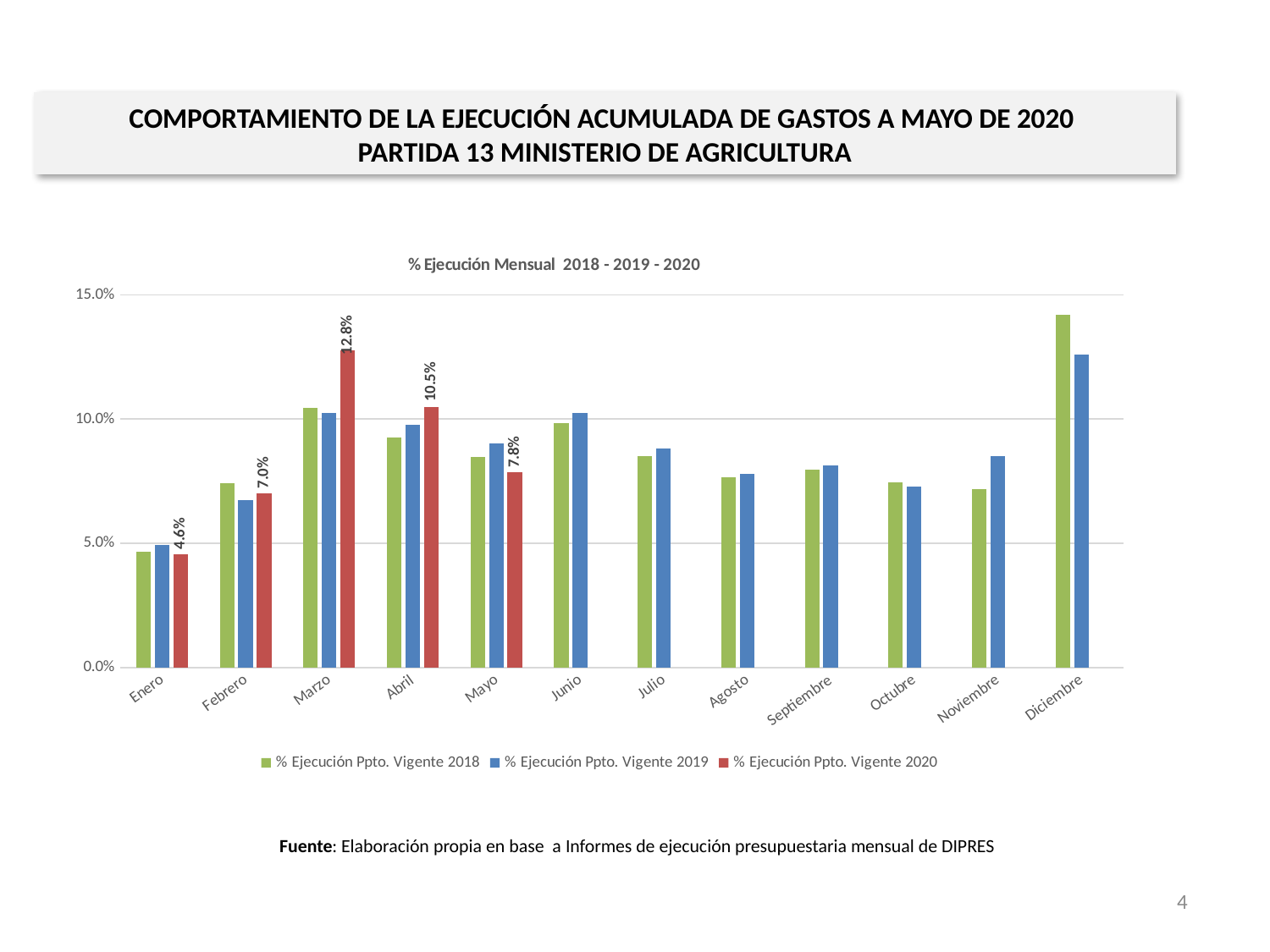
Is the value for Enero in the % Ejecución Ppto. Vigente 2018 series greater or less than 5.0%? less What is the value for Enero in the % Ejecución Ppto. Vigente 2020 series? 4.6% What is the difference between the Marzo and Abril values in the % Ejecución Ppto. Vigente 2020 series? 2.3% Is the value for Diciembre in the % Ejecución Ppto. Vigente 2018 series greater or less than 10.0%? greater How many series does the legend list? 3 Which month has the lowest value in the % Ejecución Ppto. Vigente 2020 series? Enero What is the value for Marzo in the % Ejecución Ppto. Vigente 2020 series? 12.8% In the % Ejecución Ppto. Vigente 2020 series, which is larger: Febrero or Mayo? Mayo What kind of chart is shown on the slide? bar chart Do the values in the % Ejecución Ppto. Vigente 2020 series rise or fall from Marzo to Mayo? fall How many months are shown on the x axis of the chart? 12 Which month has the highest value in the % Ejecución Ppto. Vigente 2020 series? Marzo